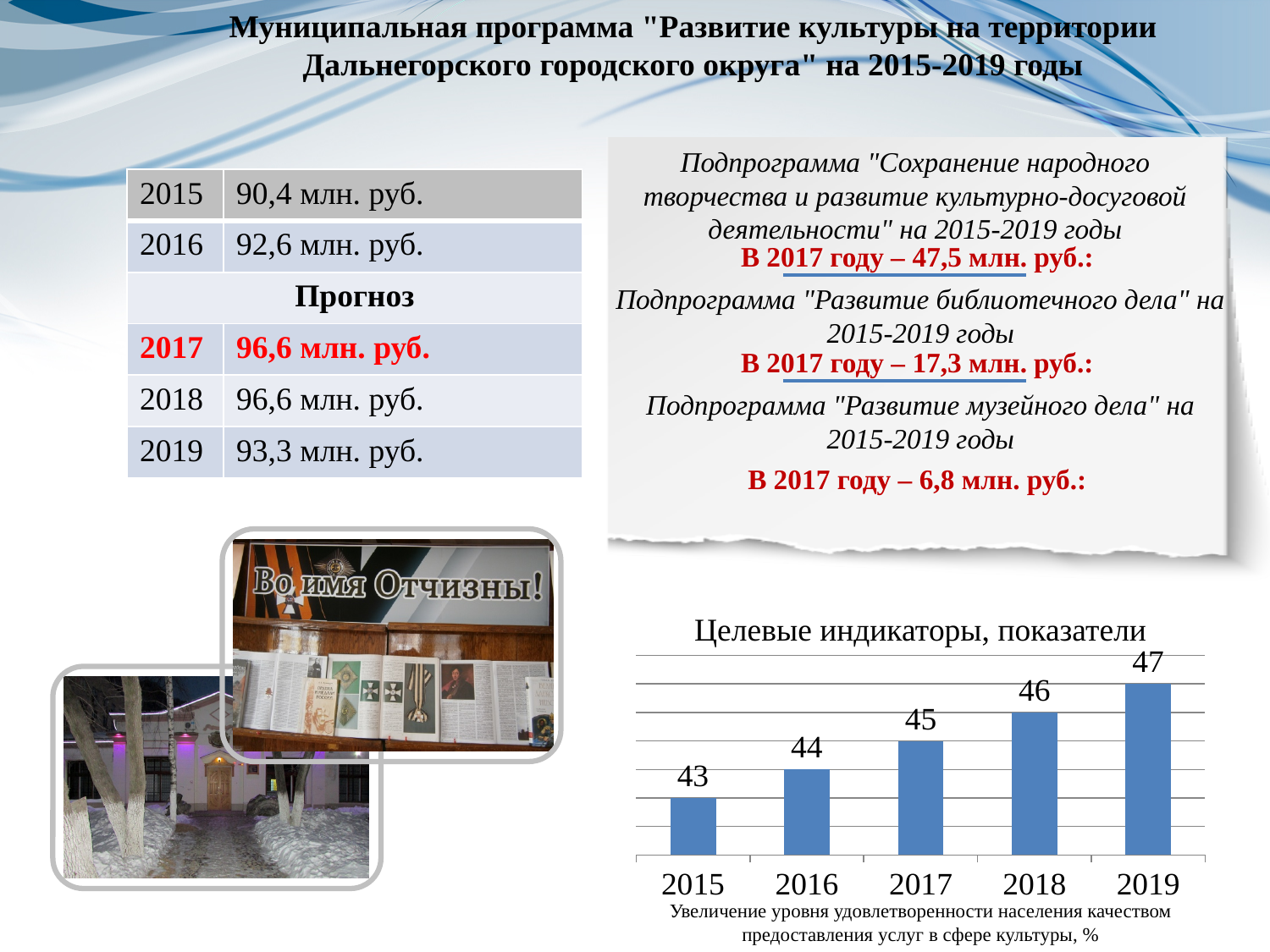
What is the value for 2019 in the chart 'Целевые индикаторы, показатели'? 47 What is the value for 2015 in the chart 'Целевые индикаторы, показатели'? 43 What is the difference between the values for 2019 and 2015 in the chart 'Целевые индикаторы, показатели'? 4 How many years are shown on the x axis of the chart 'Целевые индикаторы, показатели'? 5 Do the values in the chart 'Целевые индикаторы, показатели' rise or fall from 2015 to 2019? rise Which year has the lowest value in the chart 'Целевые индикаторы, показатели'? 2015 What is the value for 2017 in the chart 'Целевые индикаторы, показатели'? 45 In the chart 'Целевые индикаторы, показатели', which is larger: the value for 2016 or the value for 2018? 2018 Which year has the highest value in the chart 'Целевые индикаторы, показатели'? 2019 What is the title of the bar chart on the slide? Целевые индикаторы, показатели What is the difference between the values for 2018 and 2016 in the chart 'Целевые индикаторы, показатели'? 2 What kind of chart is 'Целевые индикаторы, показатели'? bar chart